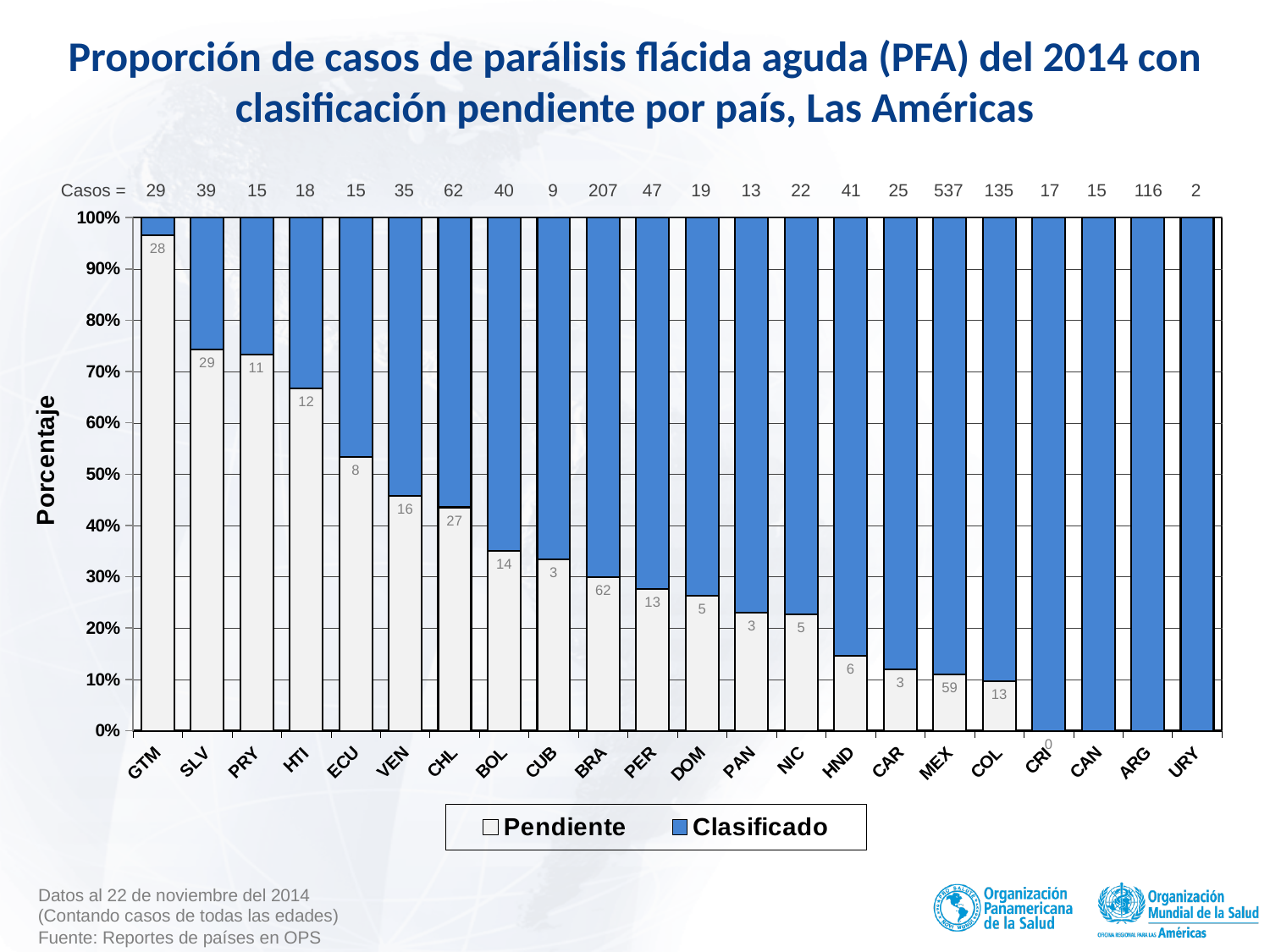
According to the 'Casos =' row above the chart, how many cases does MEX have? 537 Does the pending (Pendiente) share rise or fall moving from left to right along the x axis? Fall What is the number of pending (Pendiente) cases labelled on the bar for GTM? 28 What is the difference between the pending cases labelled for BRA and for MEX? 3 How many countries are shown on the x axis of the chart? 22 Which country has a larger pending (Pendiente) share of its bar, GTM or SLV? GTM Is the pending (Pendiente) share for GTM greater or less than 90%? greater What is the number of pending (Pendiente) cases labelled on the bar for BRA? 62 Is the pending (Pendiente) share for HND greater or less than 10%? greater What kind of chart is shown on the slide? Stacked bar chart Which country has the largest number of pending cases labelled on its bar? BRA How many series does the legend list? 2